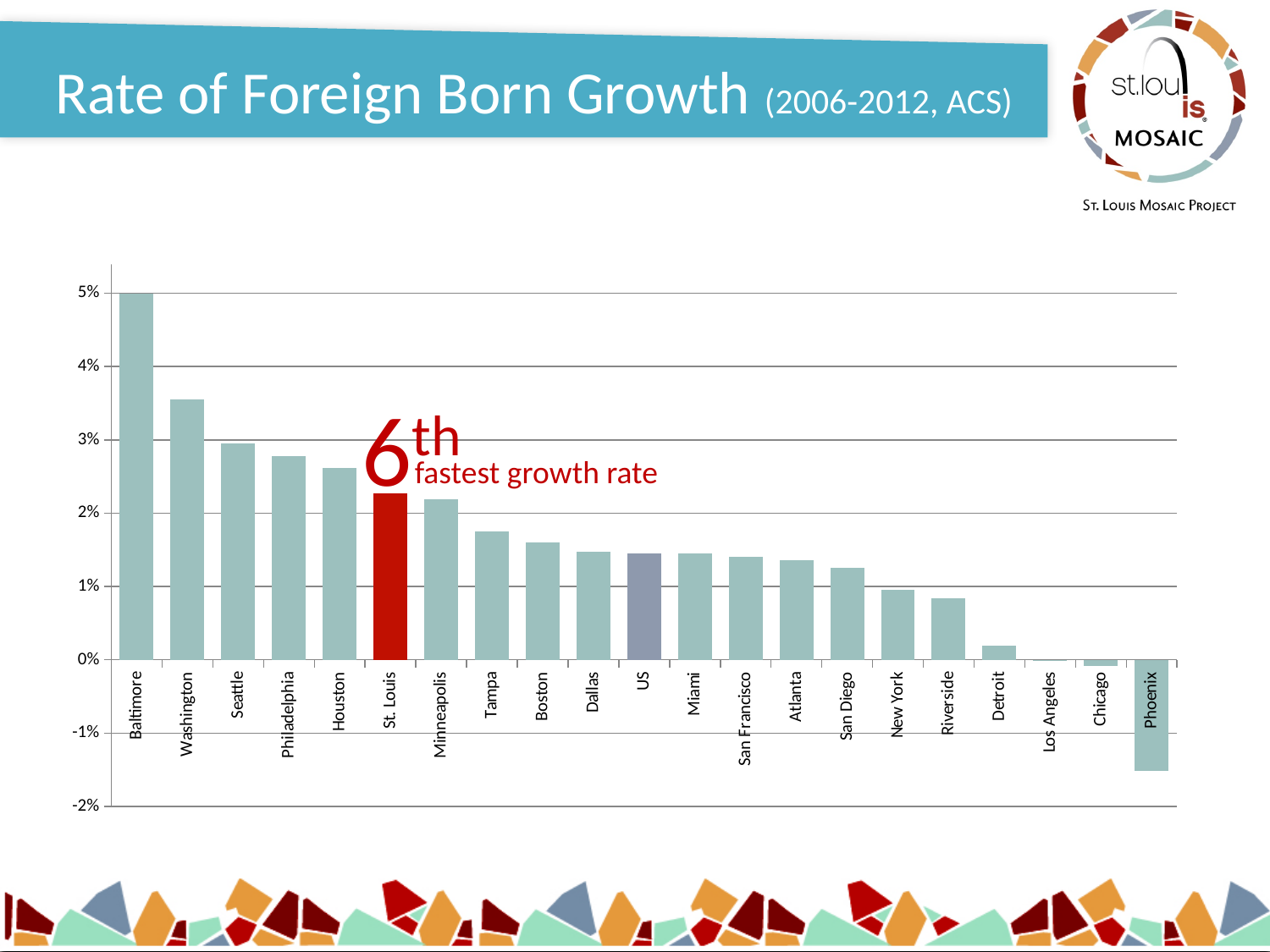
Which has a higher rate of foreign born growth, Detroit or New York? New York Which city has the lowest rate of foreign born growth? Phoenix Is the value for Phoenix greater or less than -1%? less Do the values rise or fall moving from left to right along the x axis? fall What kind of chart is shown on the slide? bar chart Which city's bar is highlighted in red? St. Louis Which has a higher rate of foreign born growth, Seattle or Houston? Seattle Is the value for Washington greater or less than 3%? greater Is the value for St. Louis greater or less than 2%? greater How many categories (bars) are shown in the chart? 21 Which city has the highest rate of foreign born growth? Baltimore